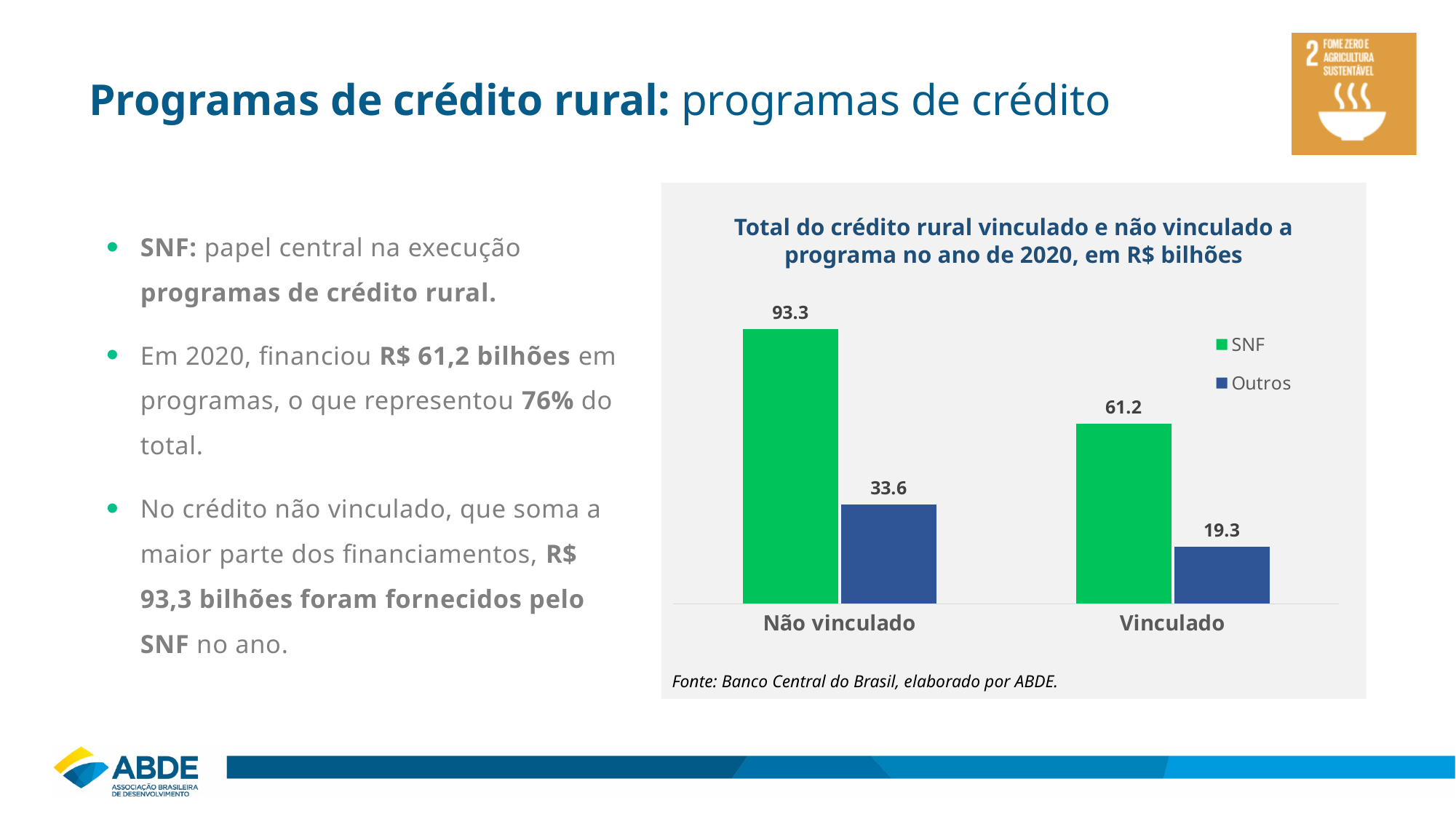
What is the Outros value for Vinculado? 19.3 What kind of chart is shown? Bar chart What is the SNF value for Não vinculado? 93.3 What is the Outros value for Não vinculado? 33.6 Which category has the lowest Outros value? Vinculado How many series does the legend list? 2 Which category has the highest SNF value? Não vinculado What is the difference between the SNF values for Não vinculado and Vinculado? 32.1 What is the difference between the SNF and Outros values for Não vinculado? 59.7 What is the SNF value for Vinculado? 61.2 Which is larger: the Outros value for Não vinculado or the Outros value for Vinculado? Não vinculado How many categories are shown on the x axis? 2